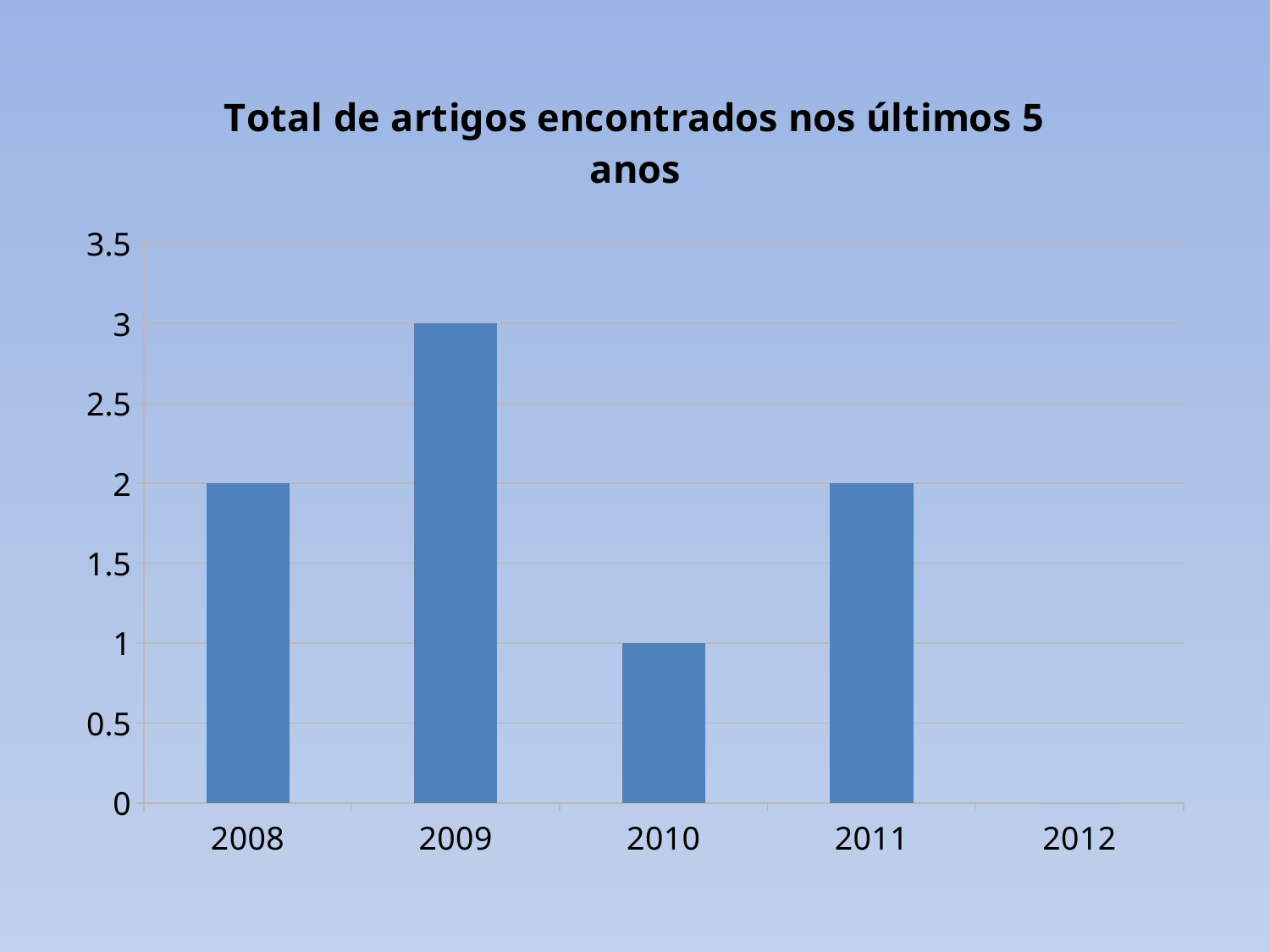
Is the value for 2009 greater or less than 2.5? greater How many years are shown on the x axis? 5 What is the difference between the values for 2009 and 2010? 2 Which year has the highest value? 2009 What is the title of the chart? Total de artigos encontrados nos últimos 5 anos What is the value for 2009? 3 Which year with a visible bar has the lowest value? 2010 Does the value rise or fall from 2009 to 2010? fall What is the value for 2010? 1 What kind of chart is this? bar chart What is the value for 2008? 2 Which is larger, the value for 2009 or the value for 2011? 2009